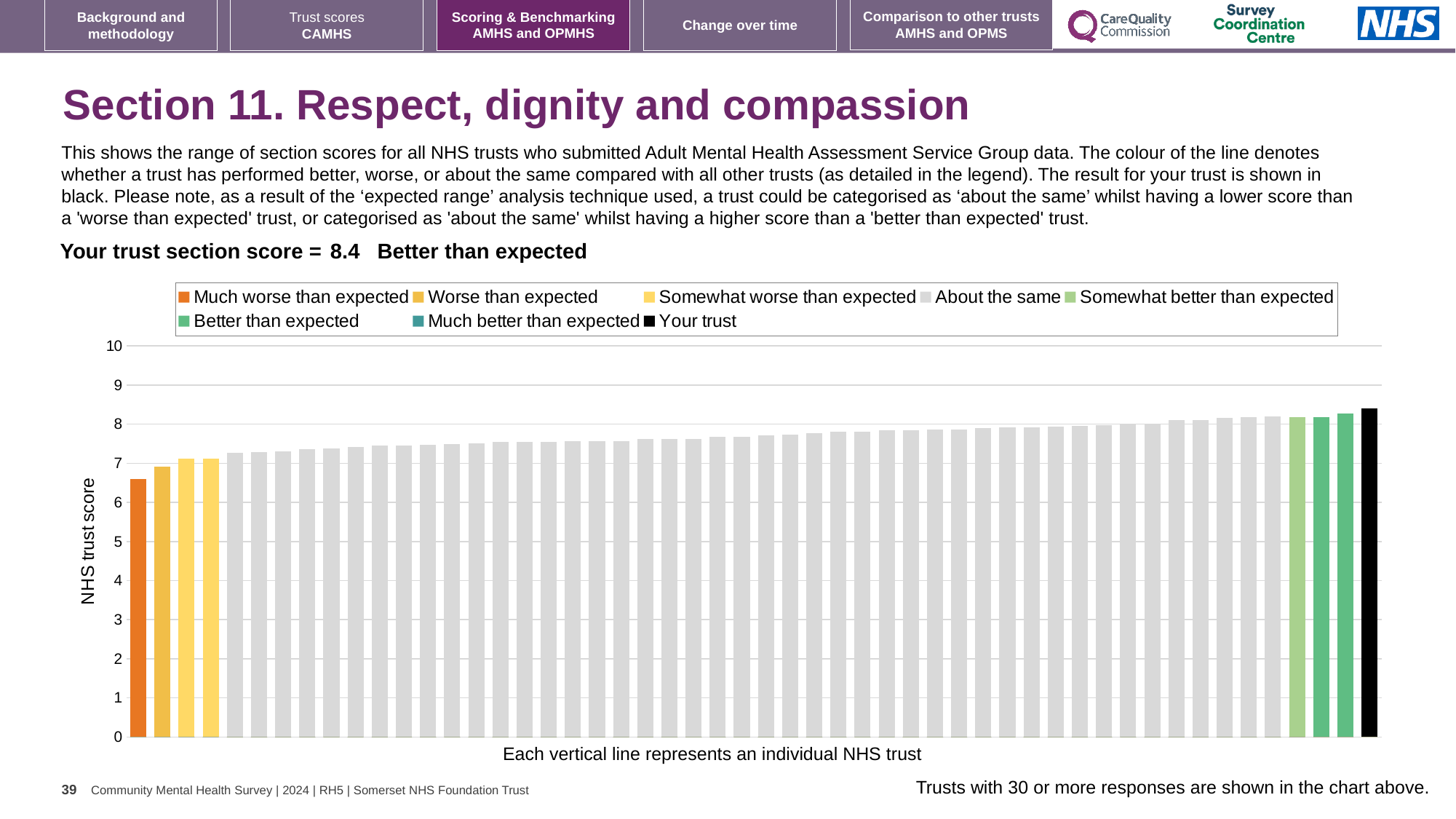
How many bars are shown in the 'Much worse than expected' colour? 1 What colour is used for the 'Your trust' bar? black What kind of chart is shown on the slide? bar chart Which bar is the highest in the chart? Your trust (the black bar) Do the bar values rise or fall from left to right along the x axis? rise Which category does the 'Your trust' score fall into according to the slide? Better than expected Is the value of the 'Much worse than expected' bar greater or less than 7? less Is the value for 'Your trust' greater or less than 8? greater What is the section score for 'Your trust' shown on the slide? 8.4 How many entries does the chart legend list? 8 What is the label on the vertical axis of the chart? NHS trust score Which legend category does the lowest bar in the chart belong to? Much worse than expected